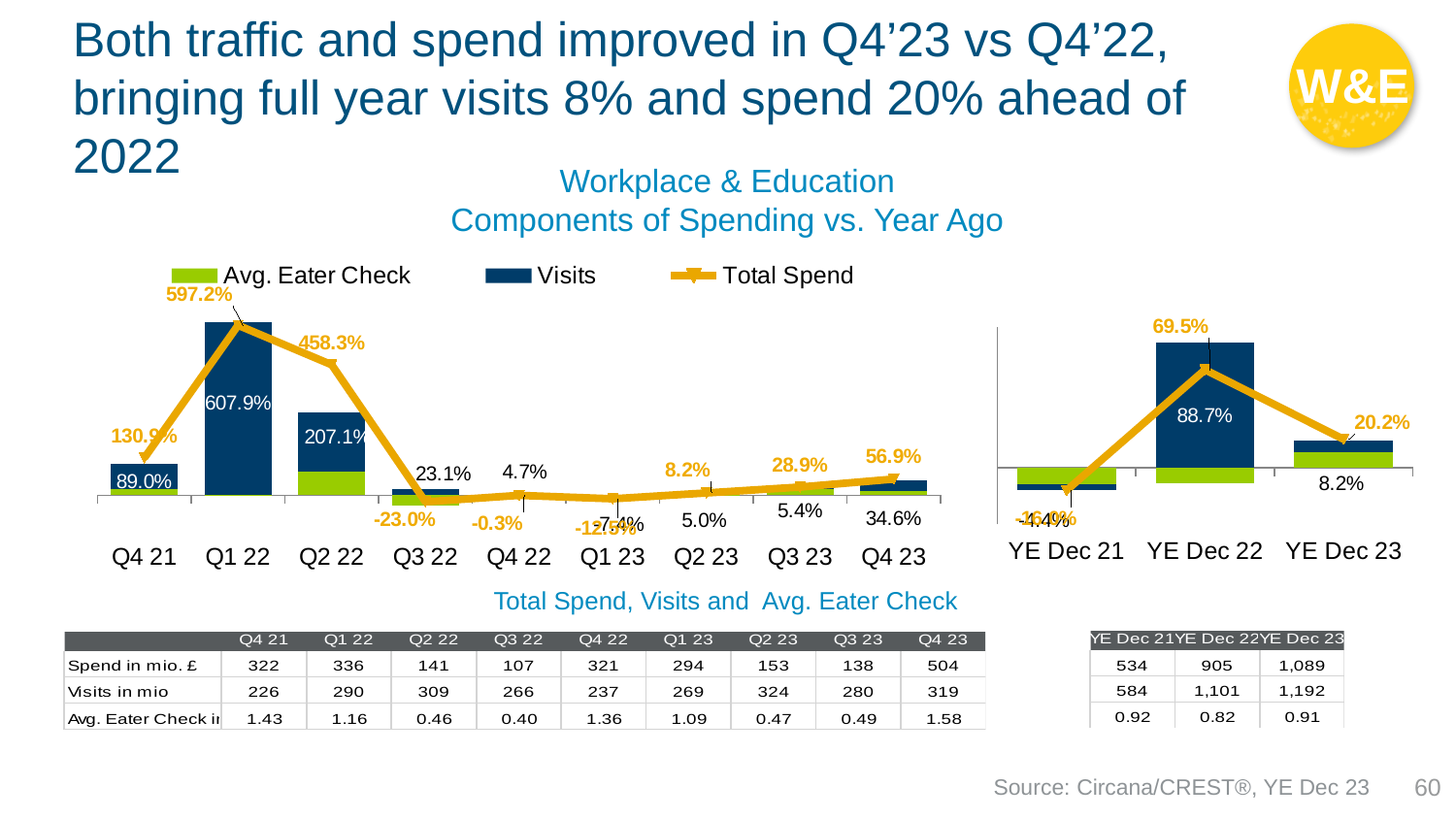
On the yearly chart on the right, what is the Total Spend value for YE Dec 22? 69.5% On the quarterly chart on the left, what is the Visits value for Q2 22? 207.1% On the quarterly chart on the left, which quarter has the highest Total Spend value? Q1 22 How many series does the legend list? 3 On the quarterly chart on the left, what is the Total Spend value for Q1 22? 597.2% On the yearly chart on the right, what is the Visits value for YE Dec 23? 8.2% On the quarterly chart on the left, what is the Visits value for Q1 22? 607.9% On the quarterly chart on the left, how many quarters are shown on the x axis? 9 On the quarterly chart on the left, what is the Total Spend value for Q4 23? 56.9% On the quarterly chart on the left, which quarter has the lowest Total Spend value? Q3 22 On the quarterly chart on the left, what is the difference between the Total Spend values for Q1 22 and Q2 22? 138.9% On the yearly chart on the right, is the Total Spend value for YE Dec 22 larger or smaller than for YE Dec 23? larger